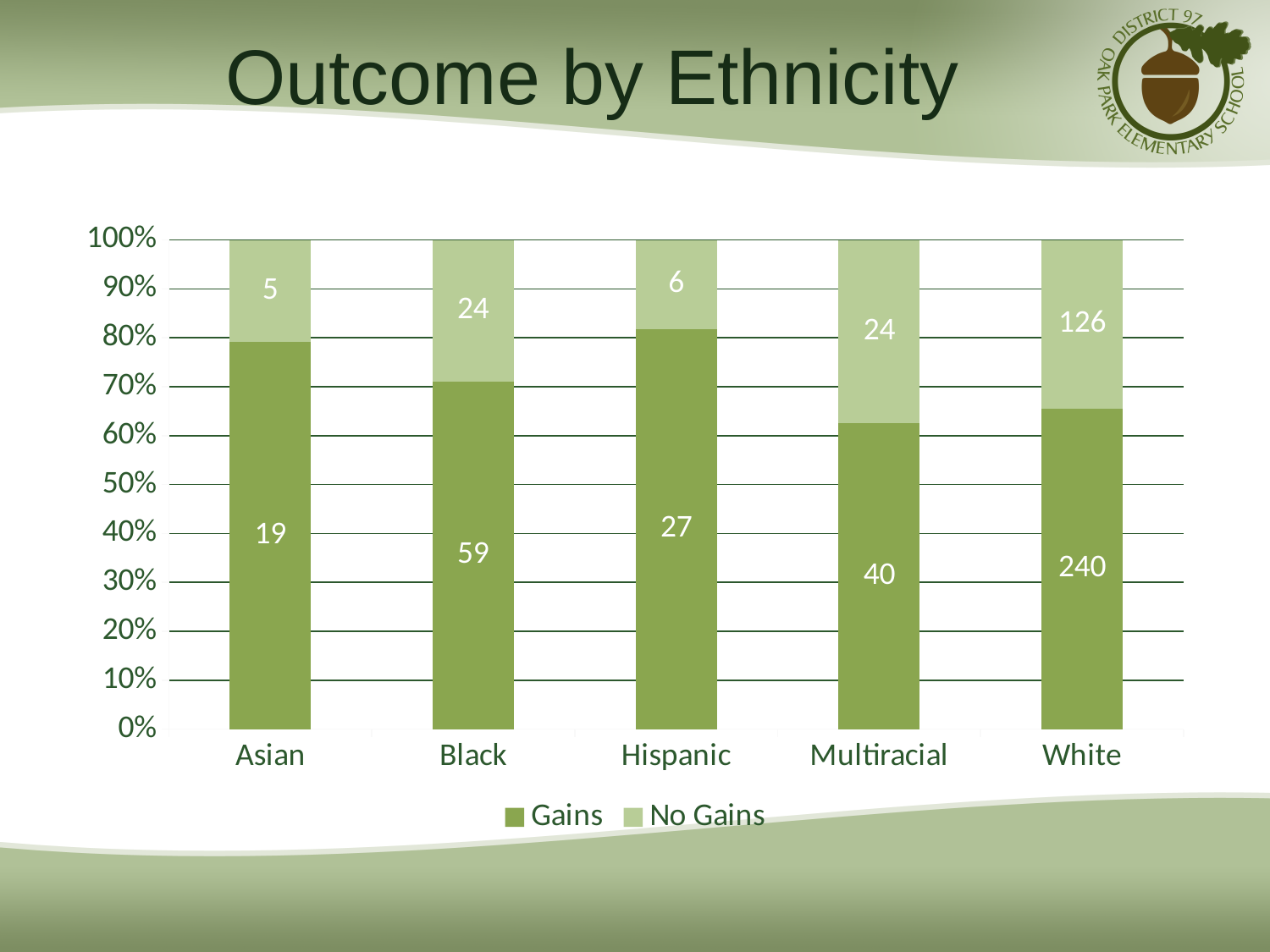
What is the No Gains value for White? 126 How many ethnicity categories are shown on the x axis? 5 What is the total of the Gains and No Gains values for Black? 83 How many series does the legend list? 2 Which ethnicity has the highest Gains value? White What is the Gains value for Black? 59 What kind of chart is shown on the slide? Stacked bar chart What is the Gains value for Multiracial? 40 Which is larger, the Gains value for Hispanic or the Gains value for Black? Black Which ethnicity has the lowest No Gains value? Asian What is the difference between the Gains and No Gains values for White? 114 Is the Gains share of the Multiracial bar greater or less than 70%? less